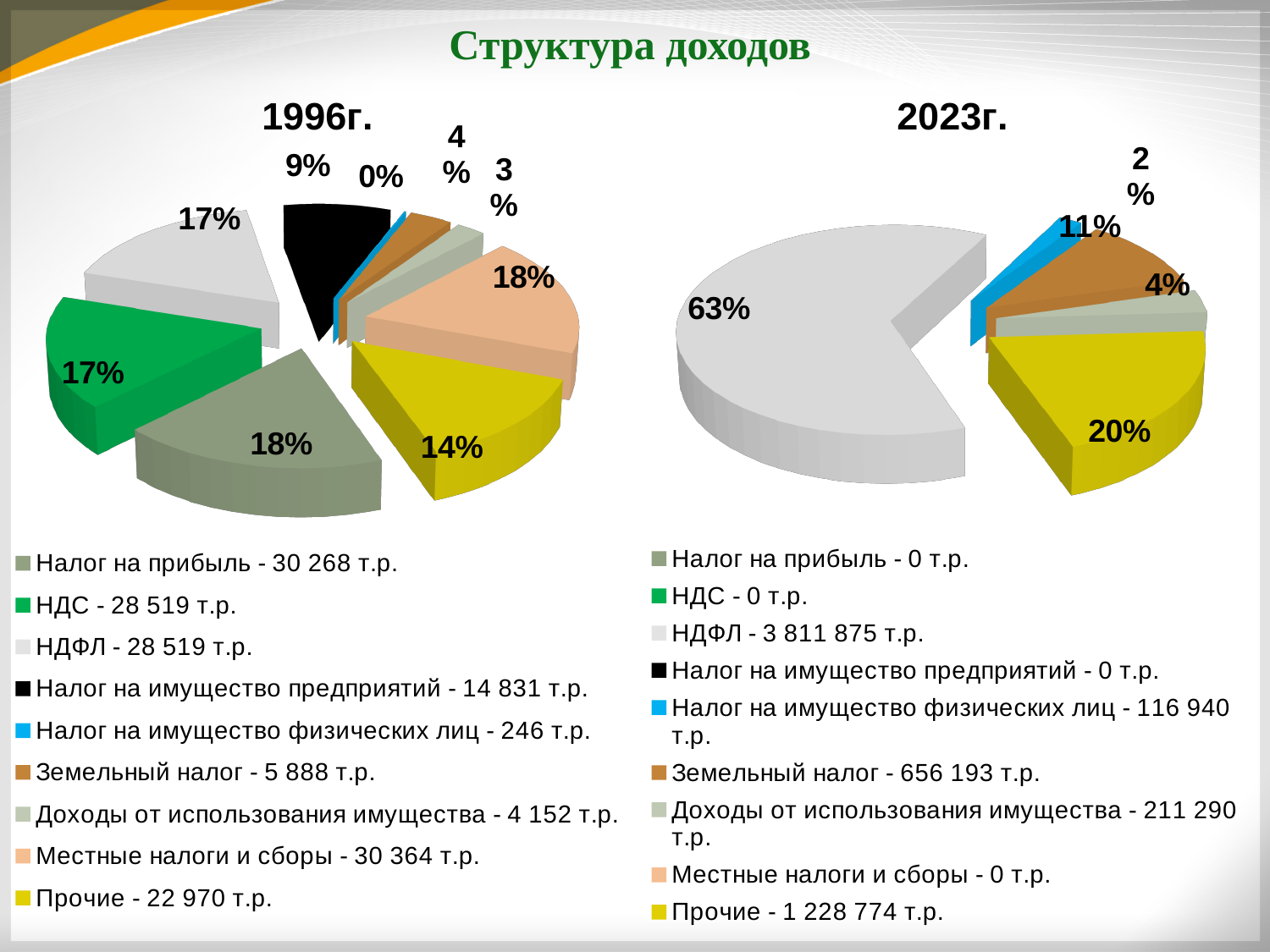
What type of chart is used for the 1996г. chart? pie chart In the 1996г. chart, what share of the pie does Прочие hold? 14% In the 2023г. chart, what value does the legend give for Земельный налог? 656 193 т.р. In the 2023г. chart, which category has the largest slice? НДФЛ How many categories does the legend of the 1996г. chart list? 9 In the 2023г. chart, what share of the pie does НДФЛ hold? 63% In the 1996г. chart, which is larger: the share for Прочие or the share for Налог на имущество предприятий? Прочие In the 2023г. chart, what is the difference in percentage points between the НДФЛ slice and the Прочие slice? 43 In the 1996г. chart, what value does the legend give for Налог на прибыль? 30 268 т.р. In the 2023г. chart, what share of the pie does Прочие hold? 20% In the 2023г. chart, what value does the legend give for Прочие? 1 228 774 т.р.